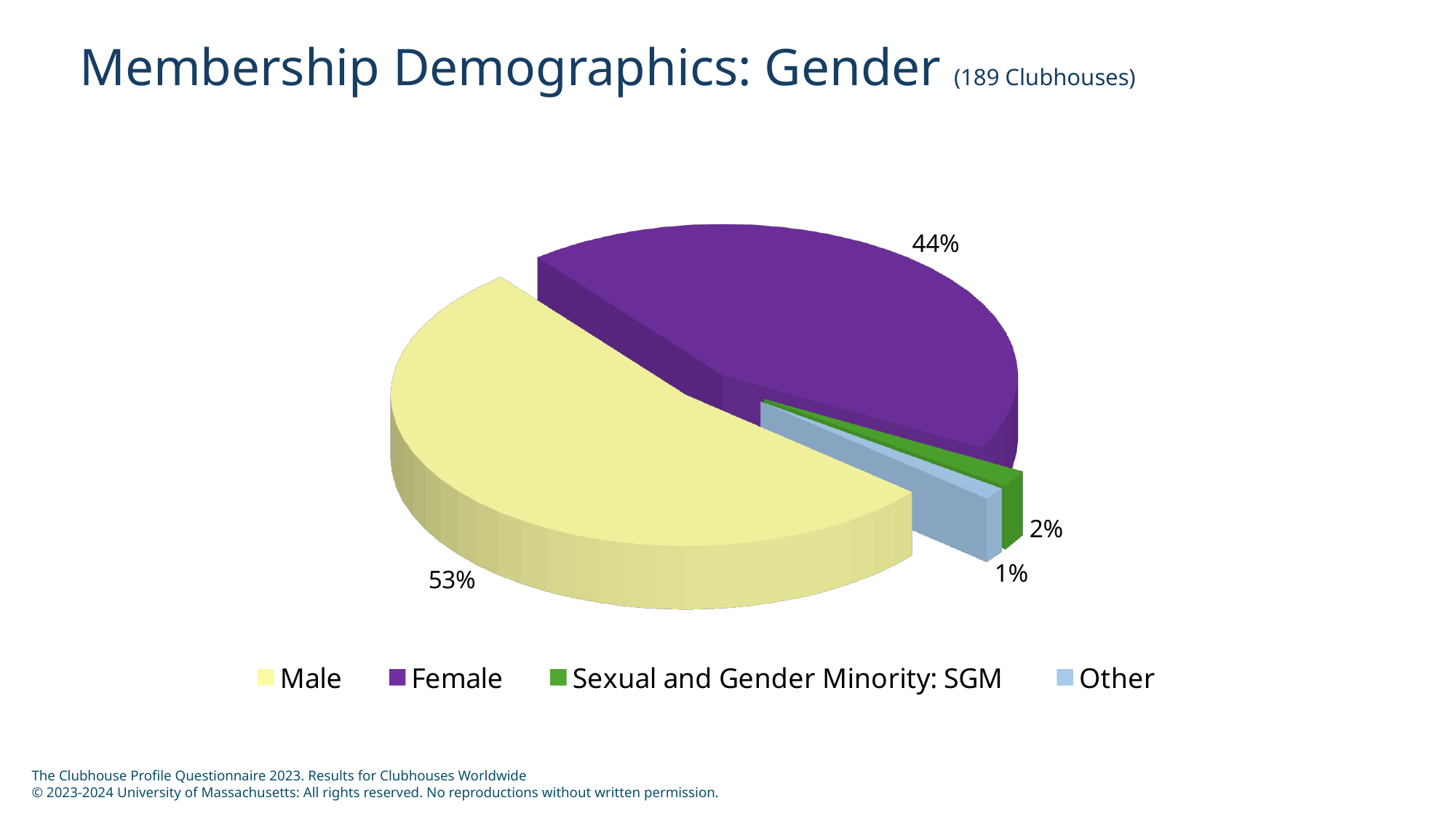
Which category has the largest share of the pie? Male How many categories does the pie chart show? 4 Which is larger, the Female share or the Male share? Male What is the difference in percentage points between Male and Female? 9 What kind of chart is shown on the slide? pie chart Which category has the smallest share of the pie? Other What percentage of membership is Male? 53% What percentage of membership is Female? 44% How many clubhouses does the chart title say the data covers? 189 What percentage of membership is Other? 1% What colour is the Female slice? purple What percentage of membership is Sexual and Gender Minority: SGM? 2%